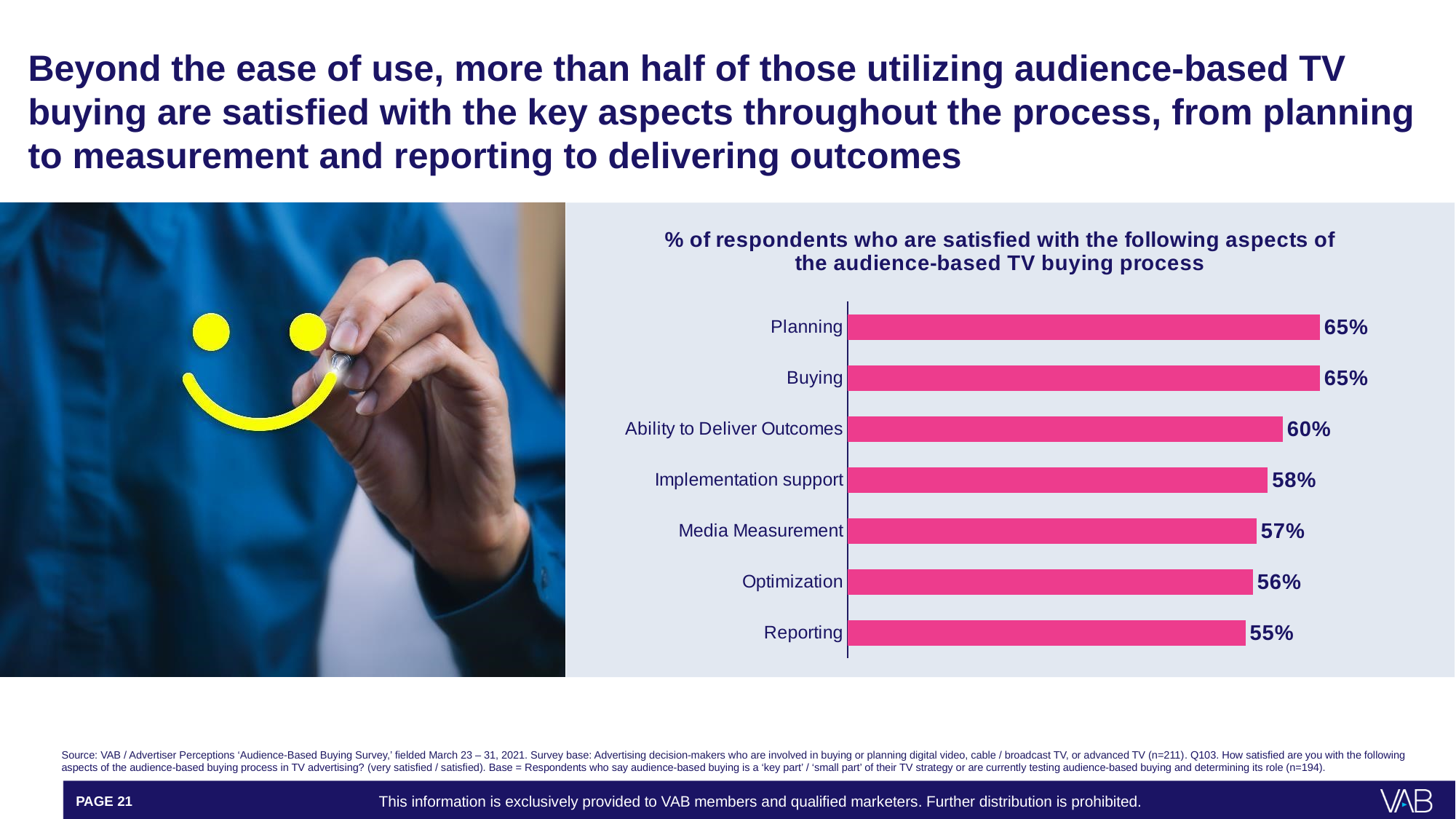
What is the value for Ability to Deliver Outcomes? 60% How many aspects are shown in the chart? 7 Which is larger, the value for Implementation support or the value for Optimization? Implementation support What percentage of respondents are satisfied with Media Measurement? 57% What is the difference between Ability to Deliver Outcomes and Optimization? 4% What is the difference between the values for Planning and Reporting? 10% What is the title of the chart? % of respondents who are satisfied with the following aspects of the audience-based TV buying process What kind of chart is shown on the slide? Bar chart What colour are the bars in the chart? Pink What percentage of respondents are satisfied with Planning? 65% What is the value for Reporting? 55% Which aspect has the lowest satisfaction percentage? Reporting